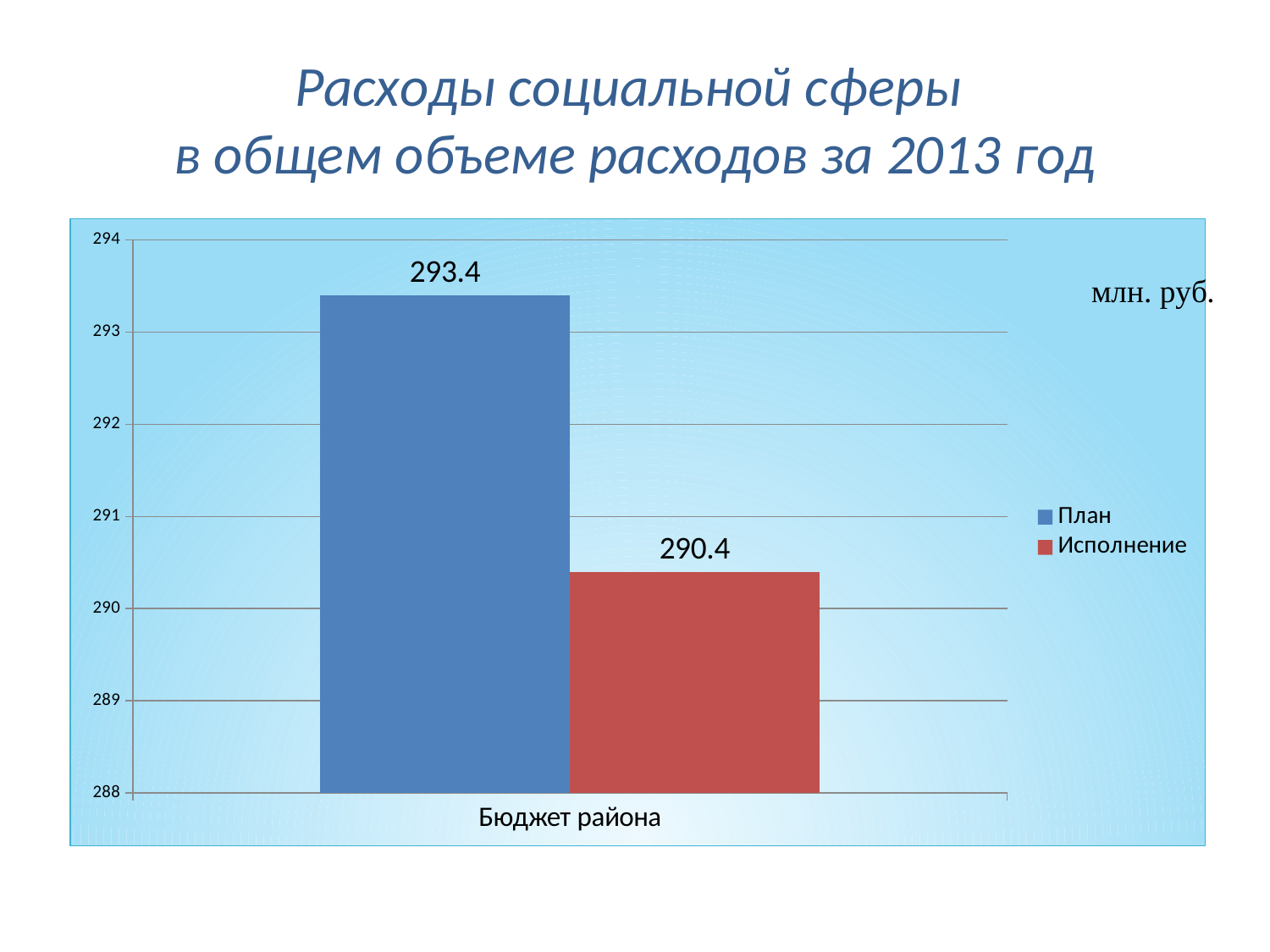
What colour is the bar for Исполнение? red What kind of chart is shown on the slide? bar chart Which series has the higher value for Бюджет района, План or Исполнение? План Is the value for План greater or less than 293? greater How many categories are shown on the x axis? 1 What is the difference between План and Исполнение for Бюджет района? 3.0 How many series does the legend list? 2 What unit is indicated on the chart? млн. руб. What is the value of Исполнение for Бюджет района? 290.4 Which series has the lowest value on the chart? Исполнение What is the value of План for Бюджет района? 293.4 Is the value for Исполнение greater or less than 291? less